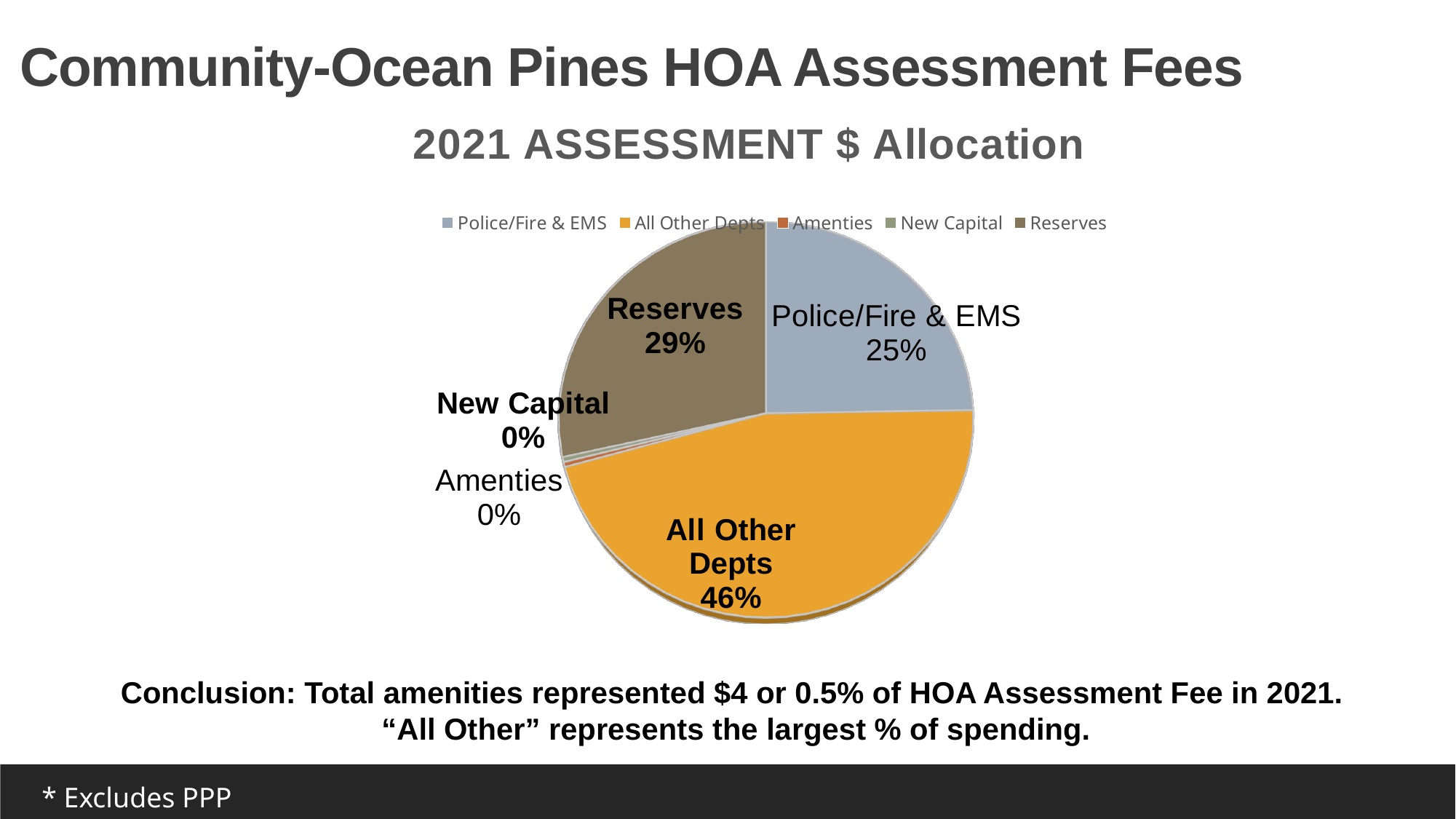
What share of the 2021 assessment allocation goes to All Other Depts? 46% What share of the 2021 assessment allocation goes to Reserves? 29% What is the difference in percentage points between All Other Depts and Reserves? 17% What type of chart is shown on the slide? pie chart What share is shown for New Capital? 0% What is the chart's title? 2021 ASSESSMENT $ Allocation Which category has the largest share of the pie? All Other Depts What is the combined share of Police/Fire & EMS and Reserves? 54% How many categories does the legend list? 5 What share of the 2021 assessment allocation goes to Police/Fire & EMS? 25% Which is larger, the share for Reserves or the share for Police/Fire & EMS? Reserves What share is shown for Amenties? 0%